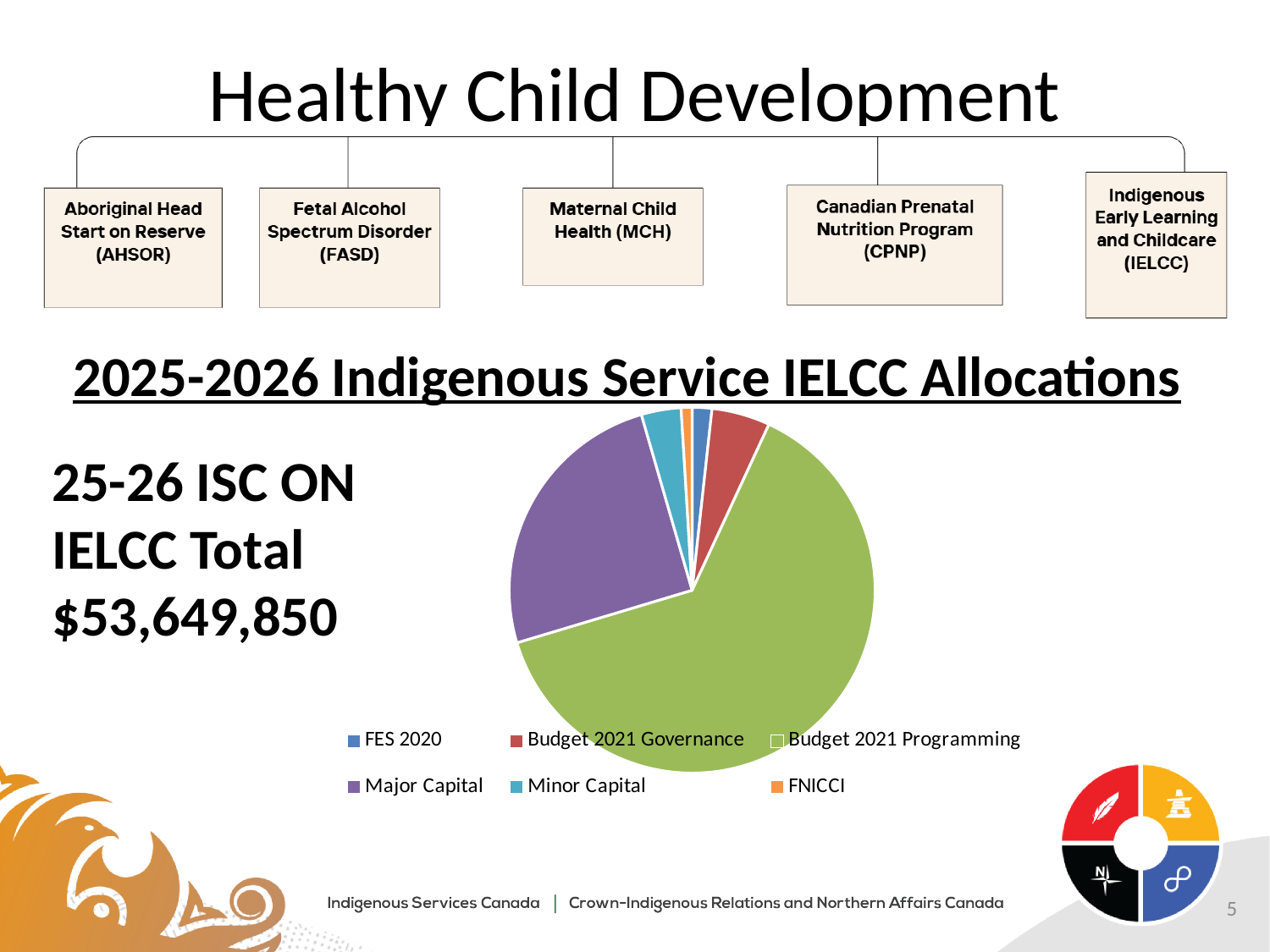
What is the 25-26 ISC ON IELCC Total stated next to the pie chart? $53,649,850 Which slice is larger in the pie chart, Budget 2021 Governance or FES 2020? Budget 2021 Governance How many categories does the legend of the pie chart list? 6 Which category has the second-largest slice of the pie chart? Major Capital Which slice is larger in the pie chart, Major Capital or Minor Capital? Major Capital Which category has the largest slice of the pie chart? Budget 2021 Programming What colour is the slice for Major Capital in the pie chart? purple Is the share of the pie for Budget 2021 Programming greater or less than 50%? greater Which category has the smallest slice of the pie chart? FNICCI What kind of chart is shown under the heading '2025-2026 Indigenous Service IELCC Allocations'? pie chart Which slice is larger in the pie chart, Budget 2021 Programming or Budget 2021 Governance? Budget 2021 Programming